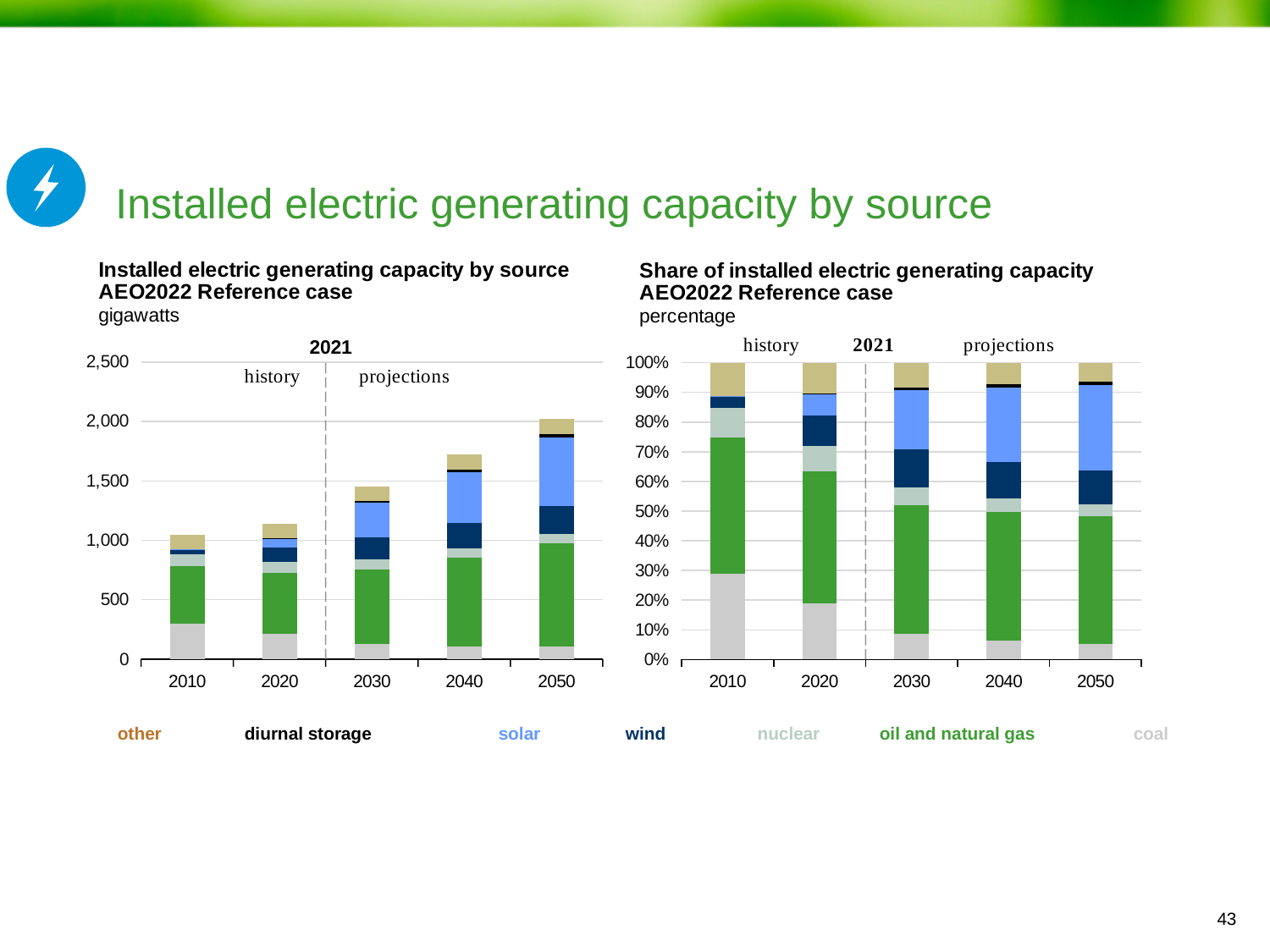
How many years are shown on the x axis of the left chart, 'Installed electric generating capacity by source'? 5 How many series does the legend at the bottom of the slide list? 7 In the left chart, 'Installed electric generating capacity by source', is the total bar for 2020 greater or less than 1,500 gigawatts? less In the right chart, 'Share of installed electric generating capacity', does the coal share rise or fall from 2010 to 2050? fall In the left chart, 'Installed electric generating capacity by source', which year has the tallest total bar? 2050 What kind of chart is the left chart, 'Installed electric generating capacity by source'? stacked bar chart In the left chart, 'Installed electric generating capacity by source', do the total bars rise or fall from 2010 to 2050? rise In the right chart, 'Share of installed electric generating capacity', is the coal share in 2010 greater or less than 20%? greater In the left chart, 'Installed electric generating capacity by source', is the total bar for 2040 greater or less than 1,500 gigawatts? greater In the left chart, 'Installed electric generating capacity by source', which year has the shortest total bar? 2010 What unit is shown under the title of the left chart? gigawatts